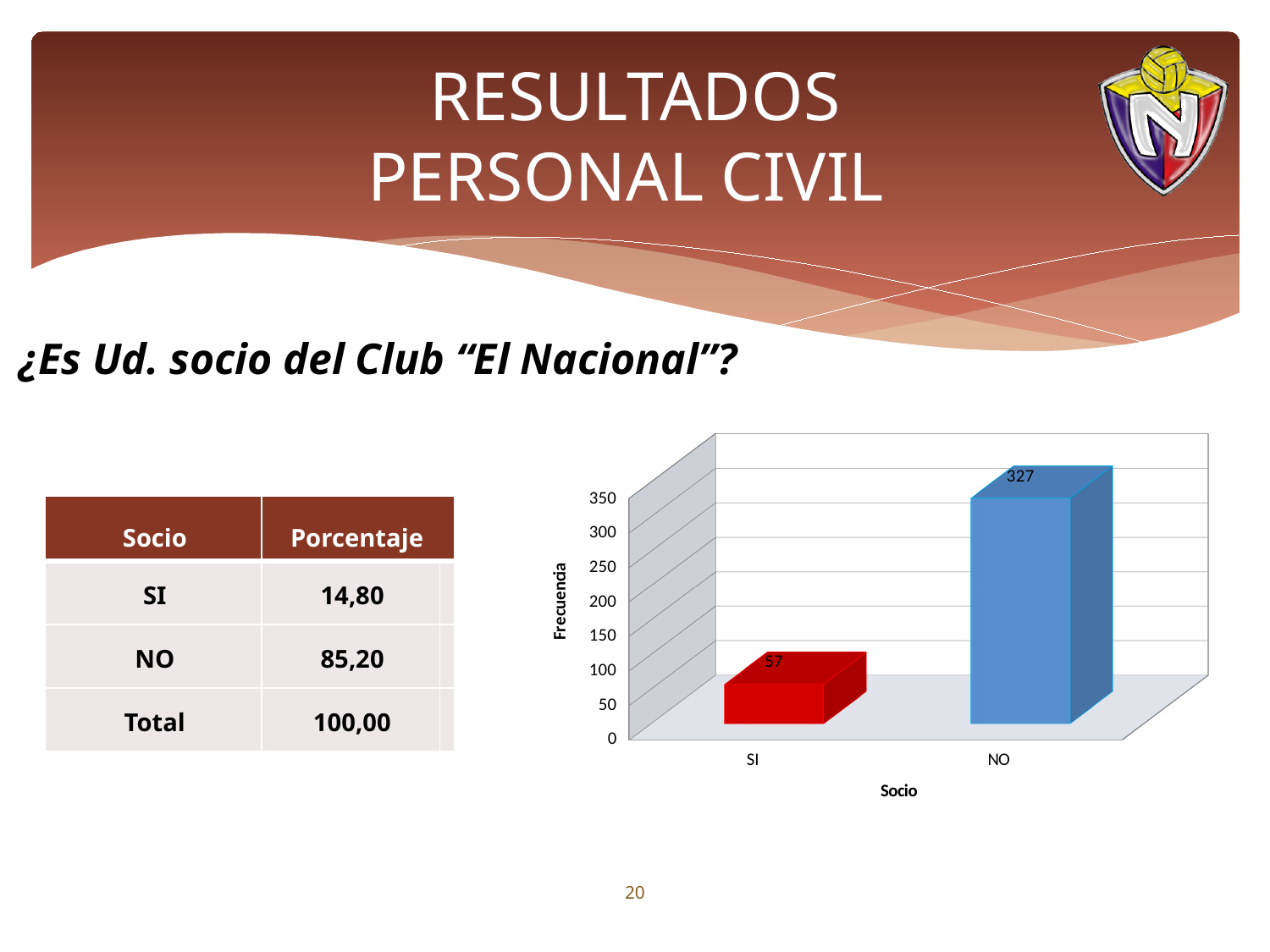
What is the difference between the values for NO and SI in the chart? 270 Which is larger in the chart, the value for SI or the value for NO? NO What is the value for NO in the chart? 327 What is the label of the vertical axis of the chart? Frecuencia Which category has the lowest value in the chart? SI Is the value for NO in the chart greater or less than 300? greater What is the label of the horizontal axis of the chart? Socio What is the value for SI in the chart? 57 What kind of chart is shown on the slide? bar chart Is the value for SI in the chart greater or less than 100? less Which category has the highest value in the chart? NO How many categories are shown on the x axis of the chart? 2